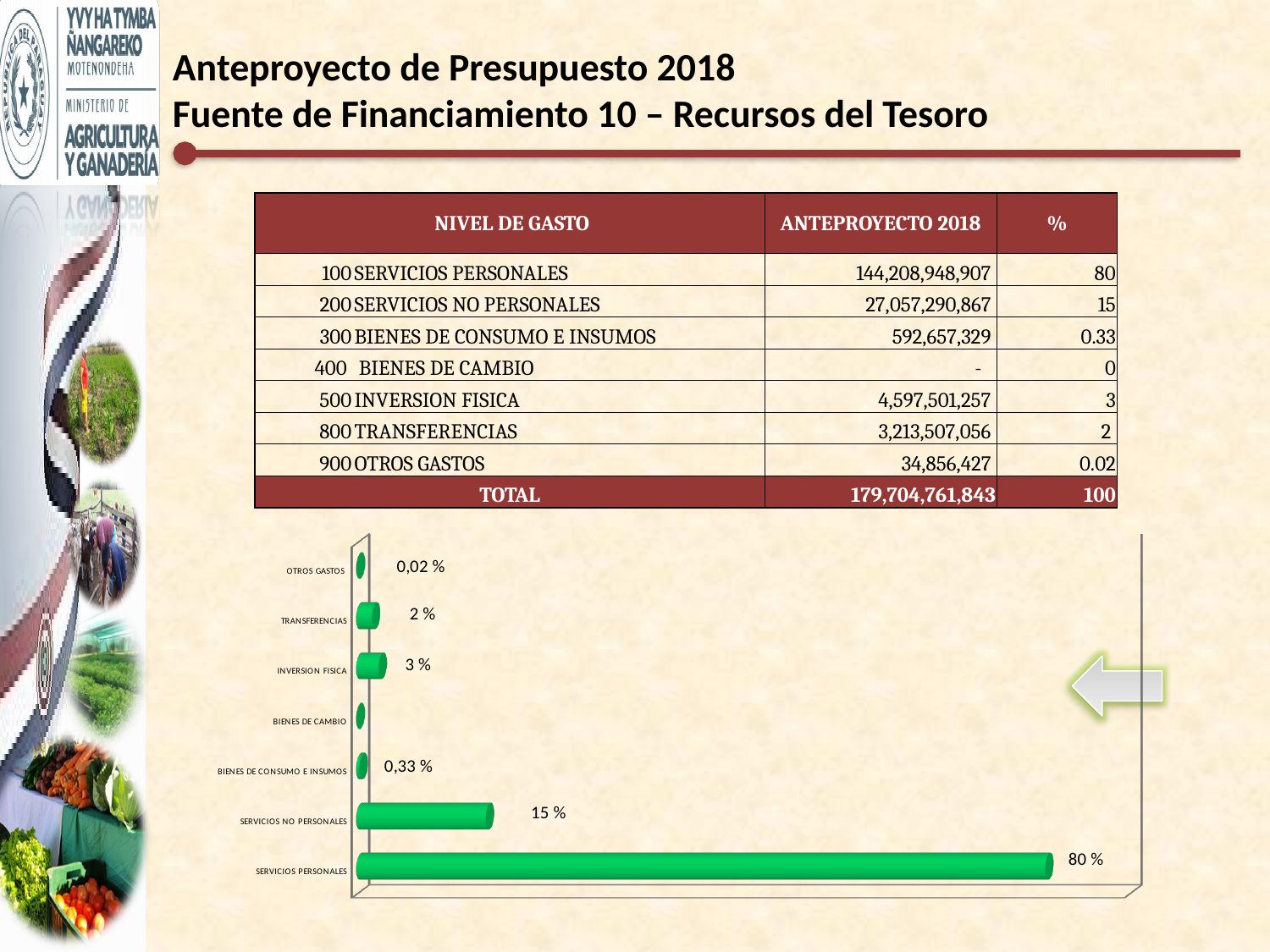
What is the value shown for OTROS GASTOS in the bar chart? 0,02 % Which category has the highest value in the bar chart? SERVICIOS PERSONALES What kind of chart is shown on the slide? Bar chart What is the value shown for SERVICIOS NO PERSONALES in the bar chart? 15 % How many categories are shown in the bar chart? 7 What is the value shown for SERVICIOS PERSONALES in the bar chart? 80 % In the bar chart, which is larger: the value for SERVICIOS NO PERSONALES or the value for INVERSION FISICA? SERVICIOS NO PERSONALES What is the difference between the values for SERVICIOS PERSONALES and SERVICIOS NO PERSONALES in the bar chart? 65 % What colour are the bars in the chart? Green What is the value shown for INVERSION FISICA in the bar chart? 3 % What is the value shown for TRANSFERENCIAS in the bar chart? 2 % What is the value shown for BIENES DE CONSUMO E INSUMOS in the bar chart? 0,33 %